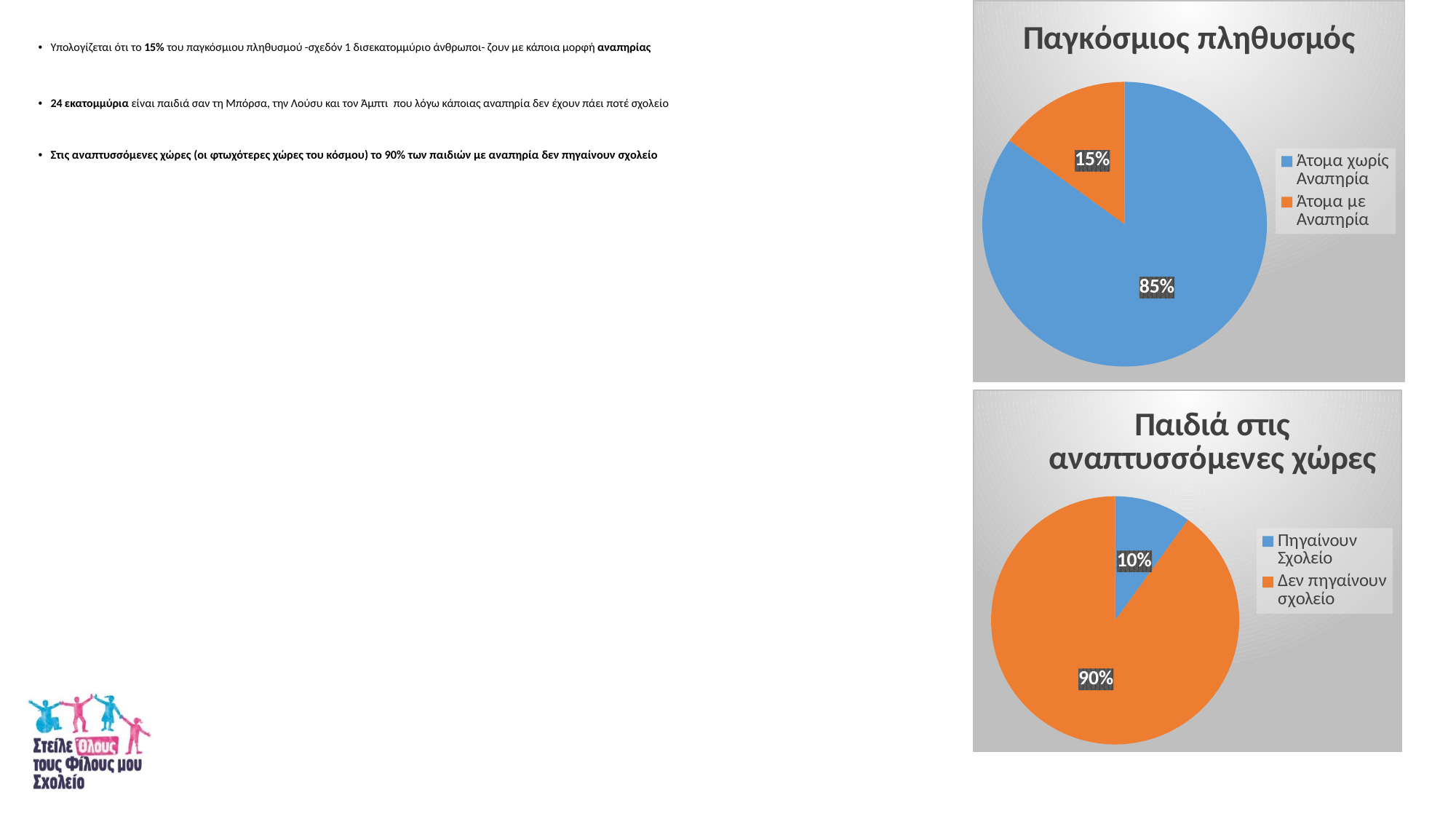
In the chart titled 'Παιδιά στις αναπτυσσόμενες χώρες', what is the value for 'Πηγαίνουν Σχολείο'? 10% In the chart titled 'Παιδιά στις αναπτυσσόμενες χώρες', which category has the smallest slice? Πηγαίνουν Σχολείο In the chart titled 'Παγκόσμιος πληθυσμός', what is the difference between the two slices? 70% In the chart titled 'Παγκόσμιος πληθυσμός', what is the value for 'Άτομα χωρίς Αναπηρία'? 85% In the chart titled 'Παγκόσμιος πληθυσμός', which category has the largest slice? Άτομα χωρίς Αναπηρία What type of chart is the top chart on the slide? Pie chart In the chart titled 'Παγκόσμιος πληθυσμός', what is the value for 'Άτομα με Αναπηρία'? 15% In the chart titled 'Παιδιά στις αναπτυσσόμενες χώρες', what is the value for 'Δεν πηγαίνουν σχολείο'? 90% In the chart titled 'Παιδιά στις αναπτυσσόμενες χώρες', what colour is the slice for 'Δεν πηγαίνουν σχολείο'? Orange How many slices does the chart titled 'Παιδιά στις αναπτυσσόμενες χώρες' have? 2 How many entries does the legend of the chart titled 'Παγκόσμιος πληθυσμός' list? 2 In the chart titled 'Παιδιά στις αναπτυσσόμενες χώρες', what is the difference between 'Δεν πηγαίνουν σχολείο' and 'Πηγαίνουν Σχολείο'? 80%